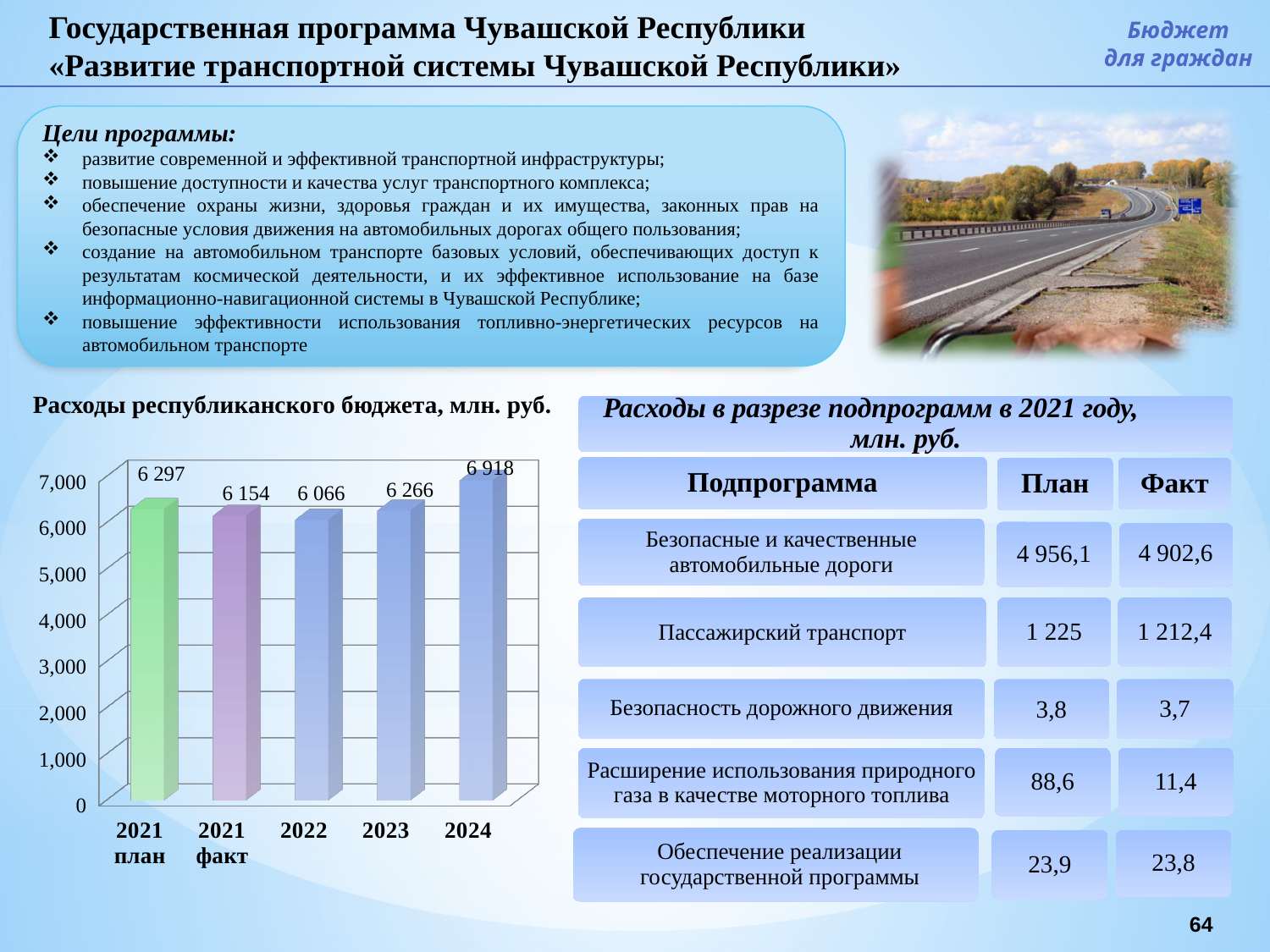
What is the value for 2021 факт in the chart 'Расходы республиканского бюджета, млн. руб.'? 6 154 What is the value for 2022 in the chart 'Расходы республиканского бюджета, млн. руб.'? 6 066 What is the difference between the 2021 план and 2021 факт values in the chart 'Расходы республиканского бюджета, млн. руб.'? 143 How many bars are shown in the chart 'Расходы республиканского бюджета, млн. руб.'? 5 What is the value for 2024 in the chart 'Расходы республиканского бюджета, млн. руб.'? 6 918 What is the difference between the 2024 and 2023 values in the chart 'Расходы республиканского бюджета, млн. руб.'? 652 Which category has the highest value in the chart 'Расходы республиканского бюджета, млн. руб.'? 2024 What is the value for 2021 план in the chart 'Расходы республиканского бюджета, млн. руб.'? 6 297 In the chart 'Расходы республиканского бюджета, млн. руб.', which is larger: the value for 2023 or the value for 2022? 2023 In the chart 'Расходы республиканского бюджета, млн. руб.', do the values rise or fall from 2022 to 2024? rise Which category has the lowest value in the chart 'Расходы республиканского бюджета, млн. руб.'? 2022 What type of chart is 'Расходы республиканского бюджета, млн. руб.'? bar chart